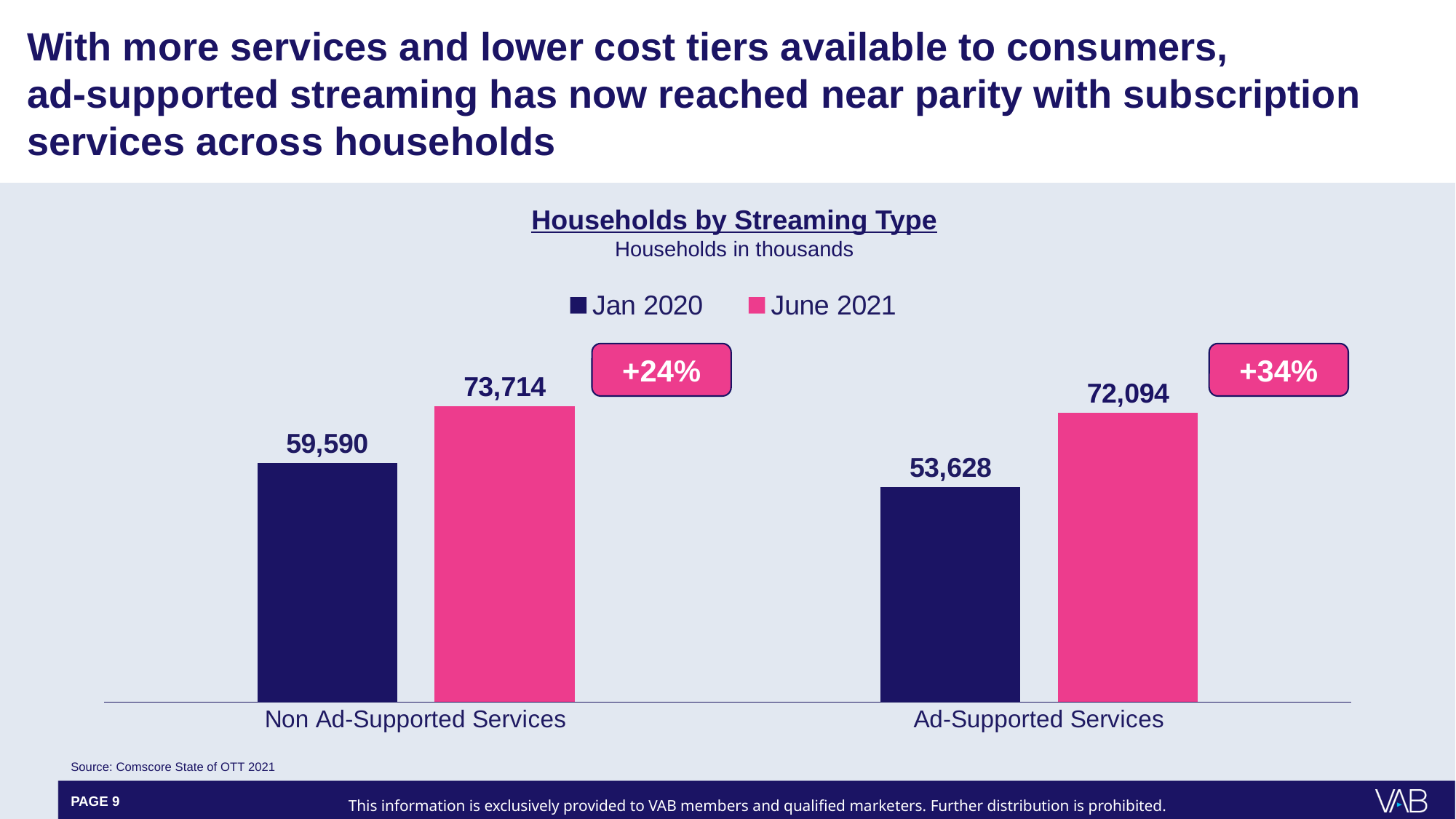
What is the difference between the June 2021 and Jan 2020 values for Ad-Supported Services? 18,466 What percentage growth is shown for Ad-Supported Services? +34% What is the difference between the June 2021 and Jan 2020 values for Non Ad-Supported Services? 14,124 How many series does the legend list? 2 What is the June 2021 value for Non Ad-Supported Services? 73,714 Which is larger in Jan 2020: Non Ad-Supported Services or Ad-Supported Services? Non Ad-Supported Services What is the Jan 2020 value for Non Ad-Supported Services? 59,590 What is the Jan 2020 value for Ad-Supported Services? 53,628 Which bar in the chart has the lowest value? Ad-Supported Services, Jan 2020 What is the June 2021 value for Ad-Supported Services? 72,094 What kind of chart is shown on the slide? Bar chart Which bar in the chart has the highest value? Non Ad-Supported Services, June 2021